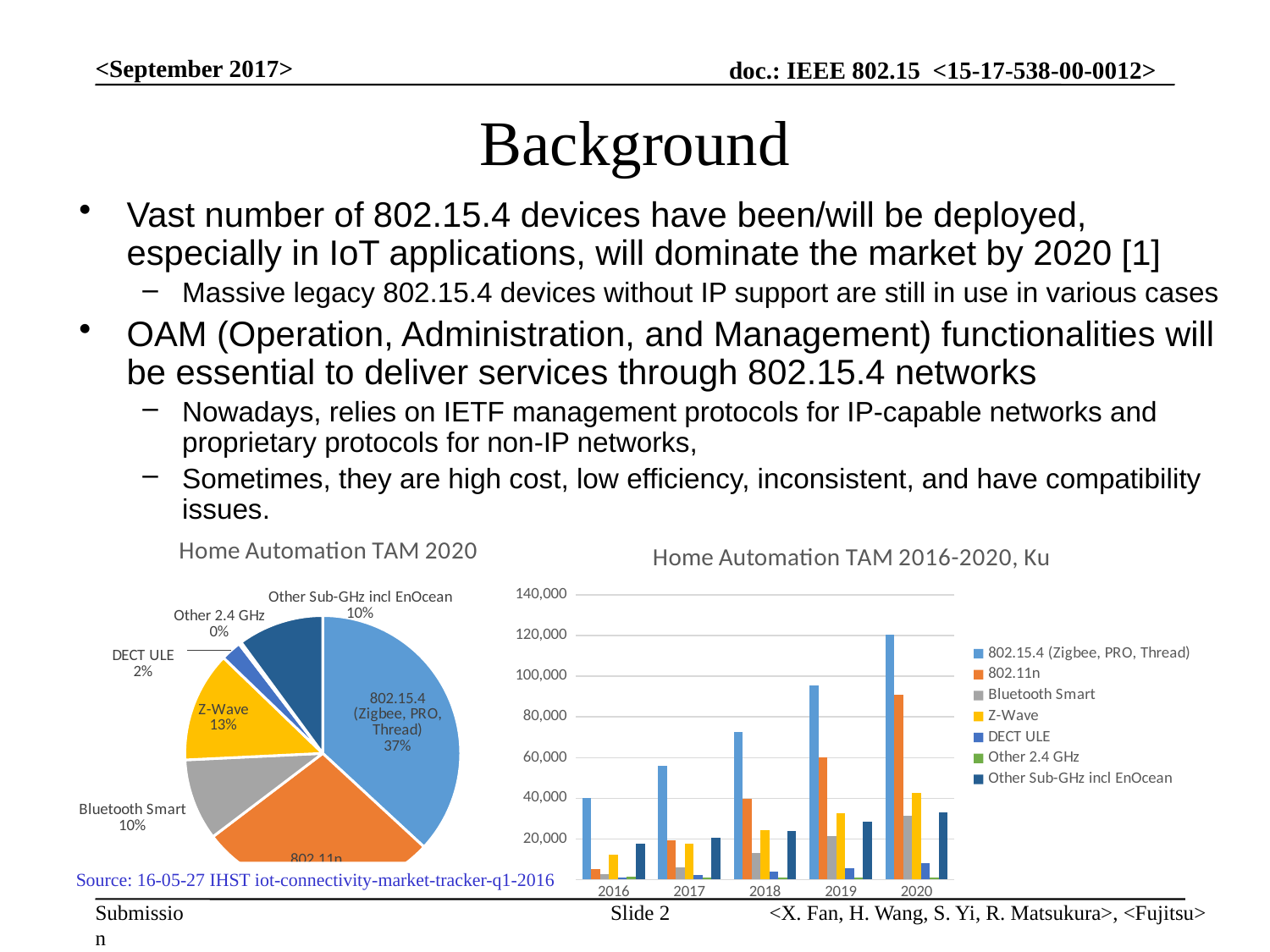
How many series does the legend of the Home Automation TAM 2016-2020, Ku chart list? 7 In the Home Automation TAM 2020 pie chart, what share does Z-Wave have? 13% In the Home Automation TAM 2020 pie chart, which slice is the largest? 802.15.4 (Zigbee, PRO, Thread) In the Home Automation TAM 2020 pie chart, what share does 802.15.4 (Zigbee, PRO, Thread) have? 37% In the Home Automation TAM 2020 pie chart, what share does DECT ULE have? 2% In the Home Automation TAM 2020 pie chart, how many percentage points larger is the 802.15.4 (Zigbee, PRO, Thread) share than the Z-Wave share? 24 What kind of chart is the Home Automation TAM 2016-2020, Ku chart? bar chart In the Home Automation TAM 2016-2020, Ku chart, do the values for 802.15.4 (Zigbee, PRO, Thread) rise or fall from 2016 to 2020? rise In the Home Automation TAM 2020 pie chart, which slice is the smallest? Other 2.4 GHz In the Home Automation TAM 2016-2020, Ku chart, is the value for 802.15.4 (Zigbee, PRO, Thread) in 2020 greater or less than 100,000? greater How many years are shown on the x axis of the Home Automation TAM 2016-2020, Ku chart? 5